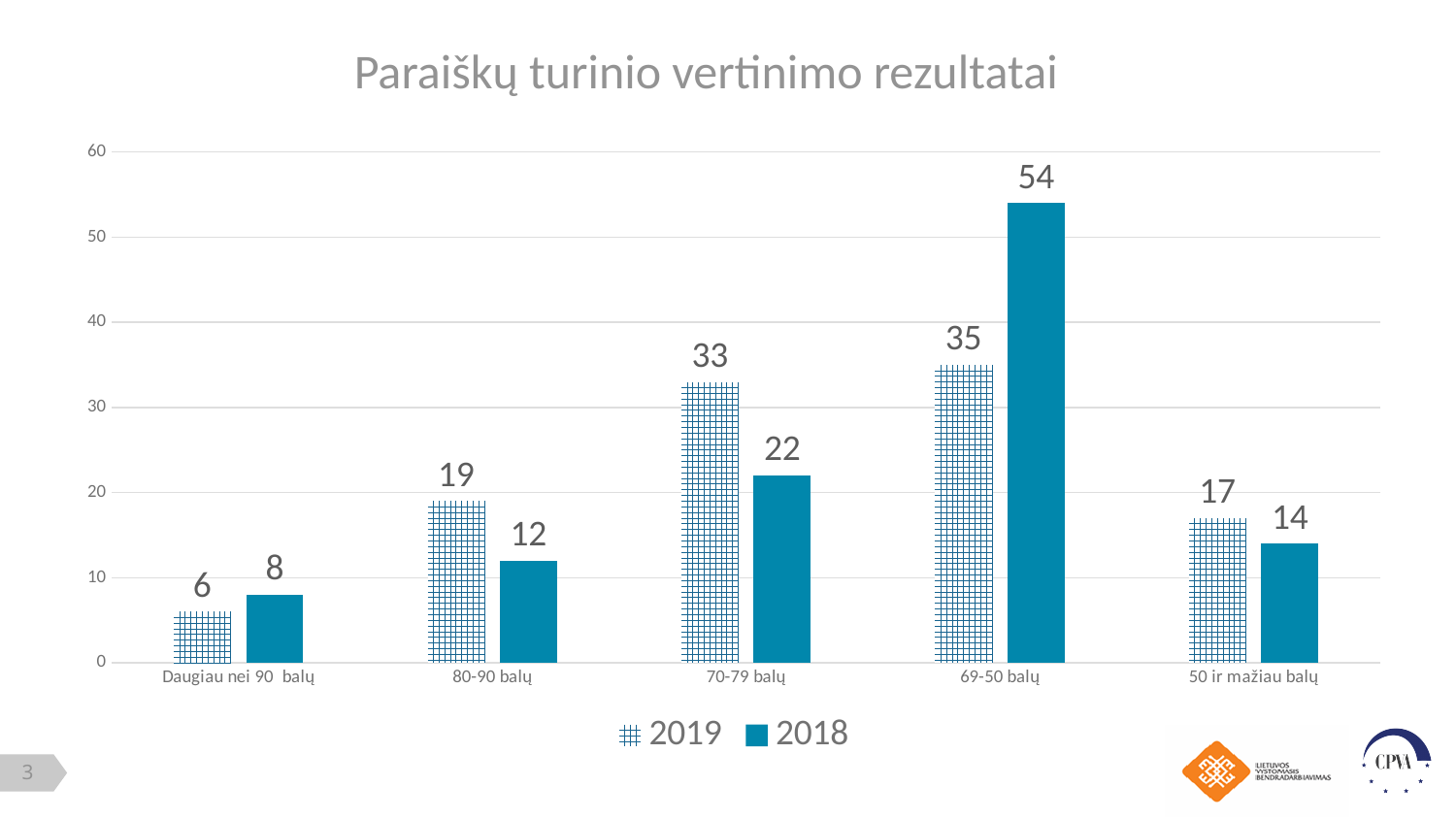
What is the value for 2019 in the '70-79 balų' category? 33 How many series does the legend list? 2 What is the difference between the 2019 and 2018 values in the '80-90 balų' category? 7 How many categories are shown on the x axis? 5 What kind of chart is shown on the slide? Bar chart What is the value for 2018 in the '69-50 balų' category? 54 What is the value for 2019 in the 'Daugiau nei 90 balų' category? 6 What is the difference between the 2018 and 2019 values in the '69-50 balų' category? 19 What is the title of the chart? Paraiškų turinio vertinimo rezultatai In the '70-79 balų' category, which series has the larger value, 2019 or 2018? 2019 Which category has the lowest value for the 2019 series? Daugiau nei 90 balų Which category has the highest value for the 2018 series? 69-50 balų